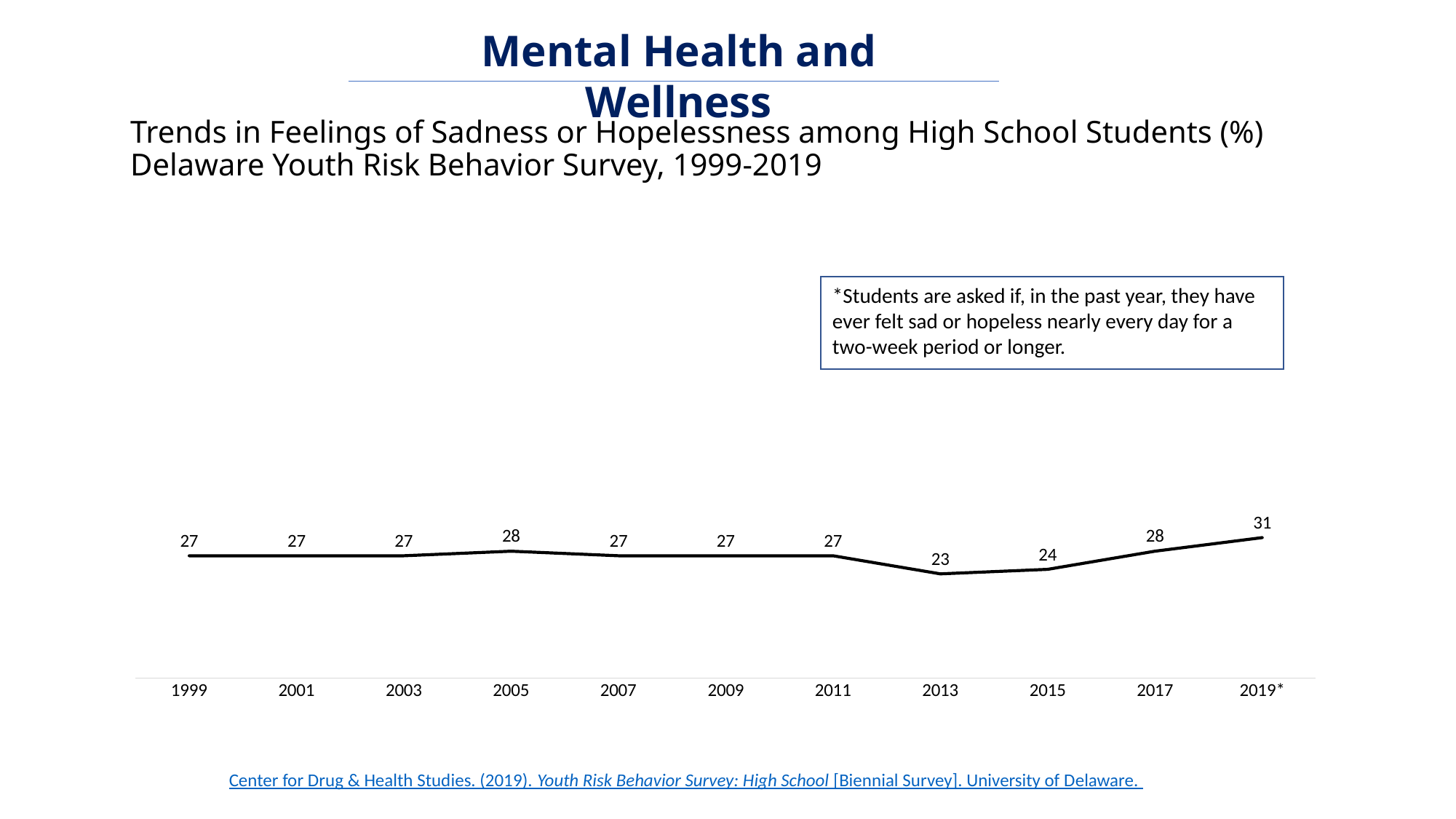
Which is larger, the value for 2011 or the value for 2013? 2011 What is the value for 2019*? 31 What is the value for 2005? 28 What is the value for 2013? 23 Which year has the highest value? 2019* What is the difference between the values for 2017 and 2015? 4 Which year has the lowest value? 2013 What kind of chart is shown? line chart Do the values rise or fall from 2013 to 2019*? rise How many years are plotted on the x axis? 11 What is the value for 2015? 24 What is the difference between the values for 2019* and 2013? 8